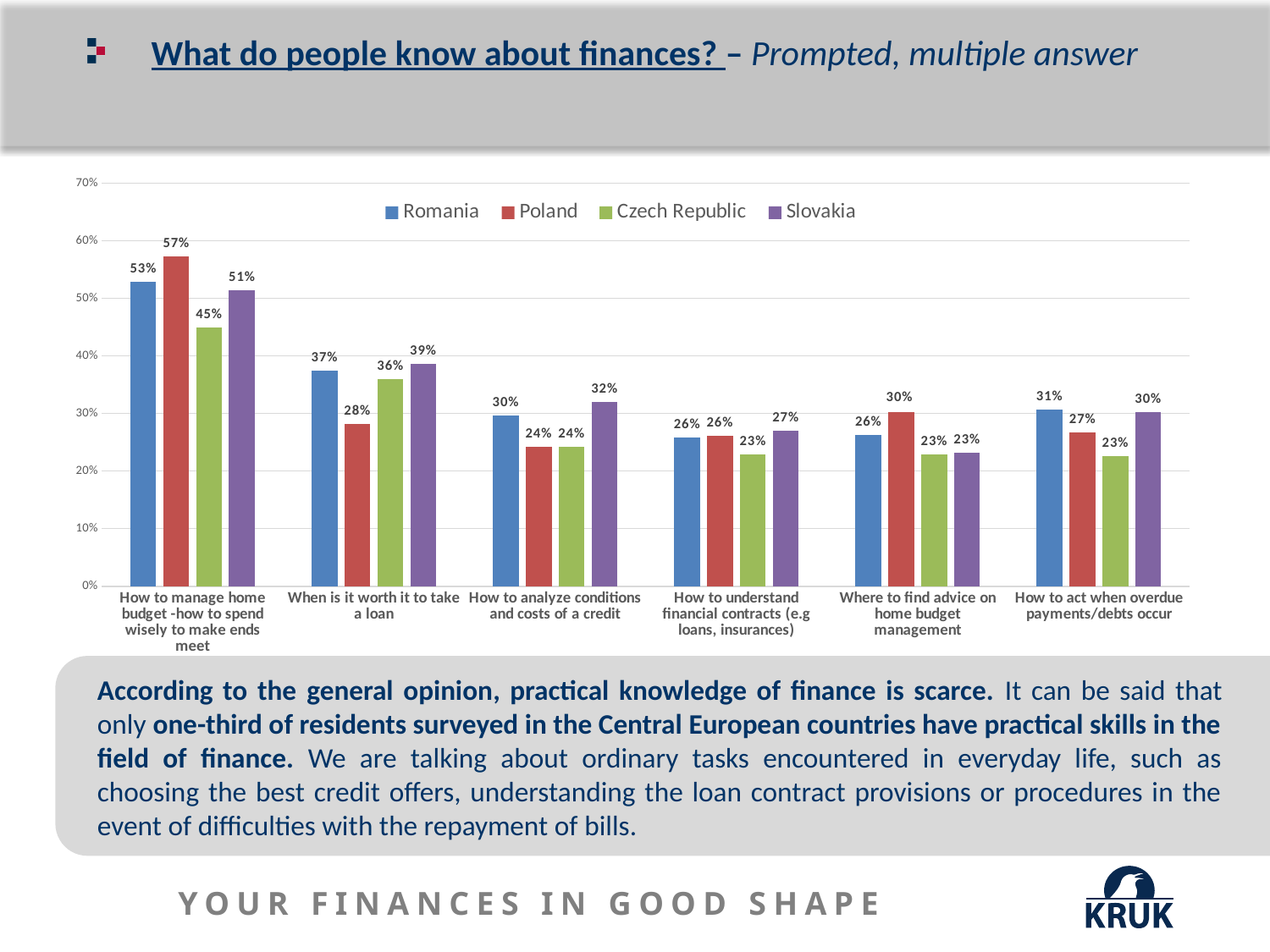
Which is larger for 'How to act when overdue payments/debts occur': Romania or Czech Republic? Romania Which colour represents Slovakia in the legend? Purple What kind of chart is shown on the slide? Bar chart Which country has the highest value for 'How to manage home budget - how to spend wisely to make ends meet'? Poland Is the value for Slovakia for 'When is it worth it to take a loan' greater or less than 30%? greater What is the value for Slovakia for 'How to analyze conditions and costs of a credit'? 32% How many series does the legend list? 4 What is the value for Poland for 'How to manage home budget - how to spend wisely to make ends meet'? 57% What is the difference between Poland and Czech Republic for 'How to manage home budget - how to spend wisely to make ends meet'? 12% Which country has the lowest value for 'When is it worth it to take a loan'? Poland What is the value for Czech Republic for 'When is it worth it to take a loan'? 36% How many categories are shown on the x axis? 6